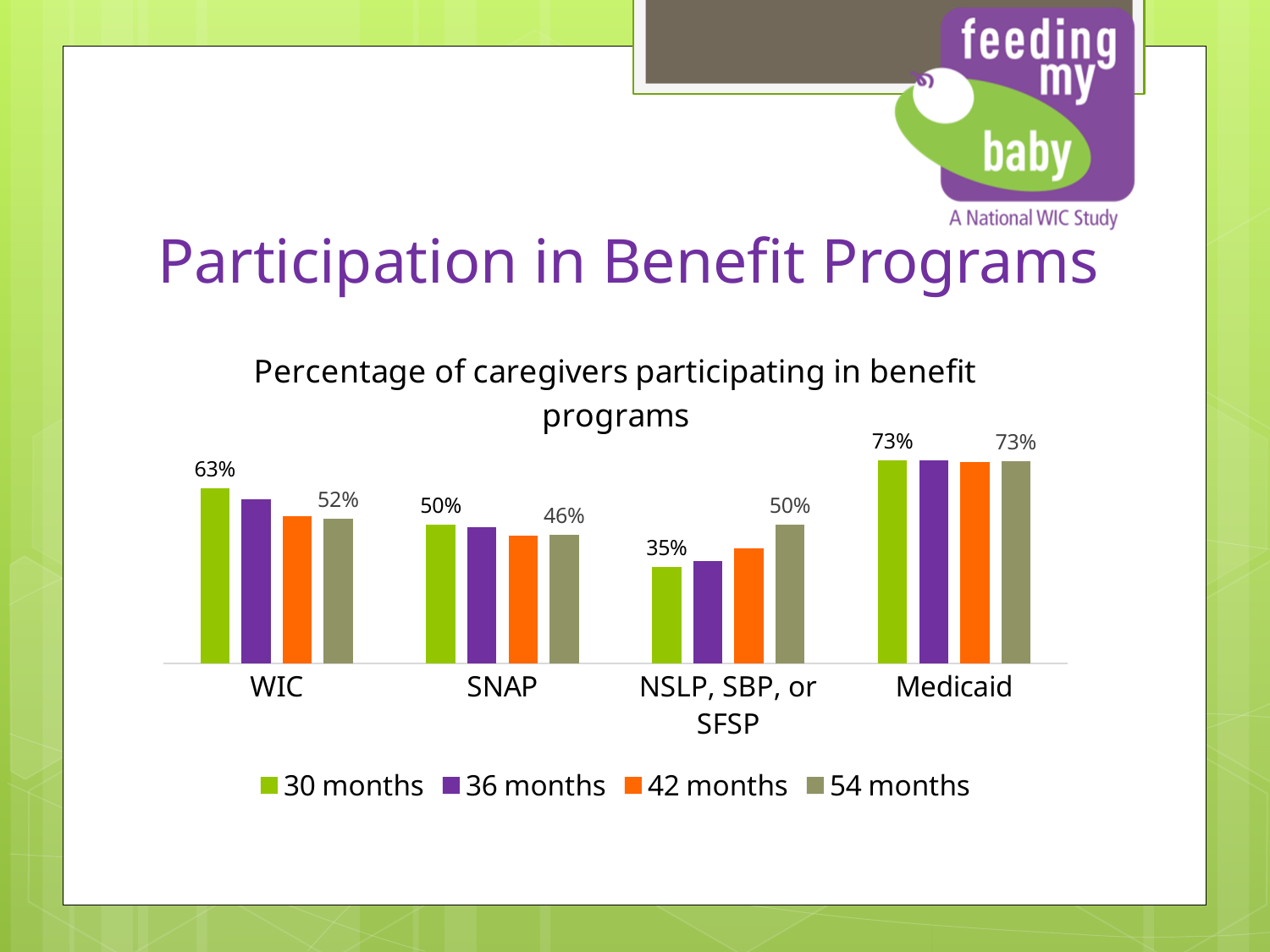
What percentage of caregivers participated in WIC at 54 months? 52% Among the 30 months bars, which benefit program has the highest participation? Medicaid How many series does the legend list? 4 What is the value for NSLP, SBP, or SFSP at 54 months? 50% How many benefit program categories are shown on the x axis? 4 By how many percentage points did WIC participation fall from 30 months to 54 months? 11 percentage points What percentage of caregivers participated in WIC at 30 months? 63% What is the value for Medicaid at 30 months? 73% By how many percentage points did NSLP, SBP, or SFSP participation rise from 30 months to 54 months? 15 percentage points At 30 months, which is larger: participation in SNAP or in NSLP, SBP, or SFSP? SNAP Does participation in NSLP, SBP, or SFSP rise or fall from 30 months to 54 months? rise Among the 30 months bars, which benefit program has the lowest participation? NSLP, SBP, or SFSP